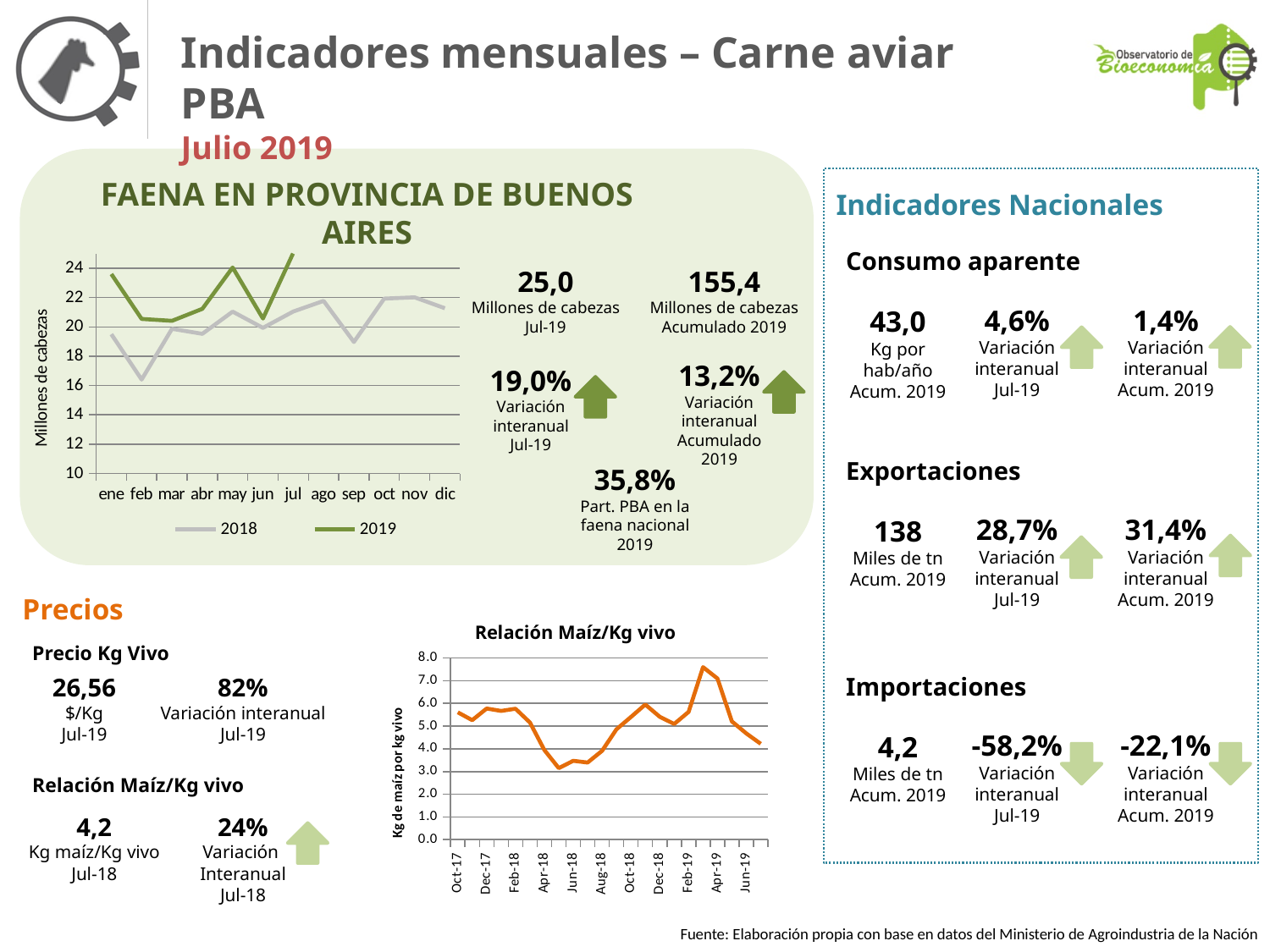
What kind of chart is the 'FAENA EN PROVINCIA DE BUENOS AIRES' chart? line chart In the 'FAENA EN PROVINCIA DE BUENOS AIRES' chart, is the 2019 value for jul greater or less than 24? greater How many series does the legend of the 'FAENA EN PROVINCIA DE BUENOS AIRES' chart list? 2 In the 'FAENA EN PROVINCIA DE BUENOS AIRES' chart, which series has the larger value in ene, 2018 or 2019? 2019 In the 'FAENA EN PROVINCIA DE BUENOS AIRES' chart, which month has the lowest 2018 value? feb How many months are shown on the x axis of the 'FAENA EN PROVINCIA DE BUENOS AIRES' chart? 12 What is the y-axis title of the 'FAENA EN PROVINCIA DE BUENOS AIRES' chart? Millones de cabezas In the 'FAENA EN PROVINCIA DE BUENOS AIRES' chart, which month has the highest 2019 value? jul In the 'Relación Maíz/Kg vivo' chart, do the values rise or fall between Dec-18 and Apr-19? rise In the 'FAENA EN PROVINCIA DE BUENOS AIRES' chart, is the 2018 value for feb greater or less than 18? less